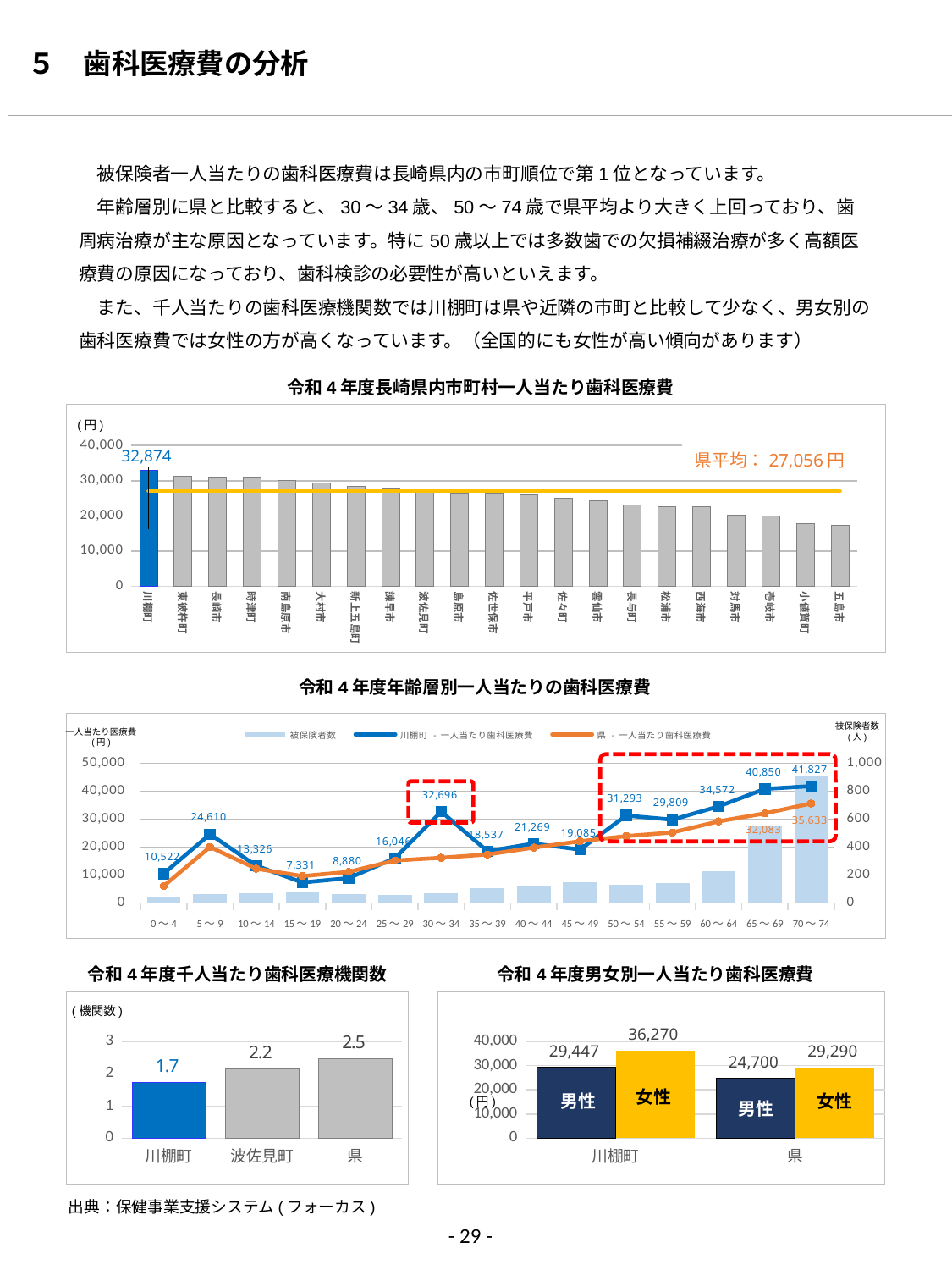
In the chart 令和4年度年齢層別一人当たりの歯科医療費, how many entries does the legend list? 3 In the chart 令和4年度男女別一人当たり歯科医療費, what is the difference between the 女性 and 男性 values for 県? 4,590 In the chart 令和4年度千人当たり歯科医療機関数, which category has the lowest value? 川棚町 In the chart 令和4年度長崎県内市町村一人当たり歯科医療費, which municipality has the highest value? 川棚町 In the chart 令和4年度年齢層別一人当たりの歯科医療費, what is the 川棚町 value for the 30～34 age group? 32,696 In the chart 令和4年度年齢層別一人当たりの歯科医療費, what is the difference between the 川棚町 value and the 県 value for the 70～74 age group? 6,194 In the chart 令和4年度年齢層別一人当たりの歯科医療費, how many age groups are shown on the x axis? 15 In the chart 令和4年度長崎県内市町村一人当たり歯科医療費, what is the 県平均 value shown? 27,056円 In the chart 令和4年度長崎県内市町村一人当たり歯科医療費, is the value for 五島市 greater or less than 20,000? less In the chart 令和4年度千人当たり歯科医療機関数, what is the value for 波佐見町? 2.2 In the chart 令和4年度長崎県内市町村一人当たり歯科医療費, what is the value for 川棚町? 32,874 In the chart 令和4年度男女別一人当たり歯科医療費, what is the 女性 value for 川棚町? 36,270